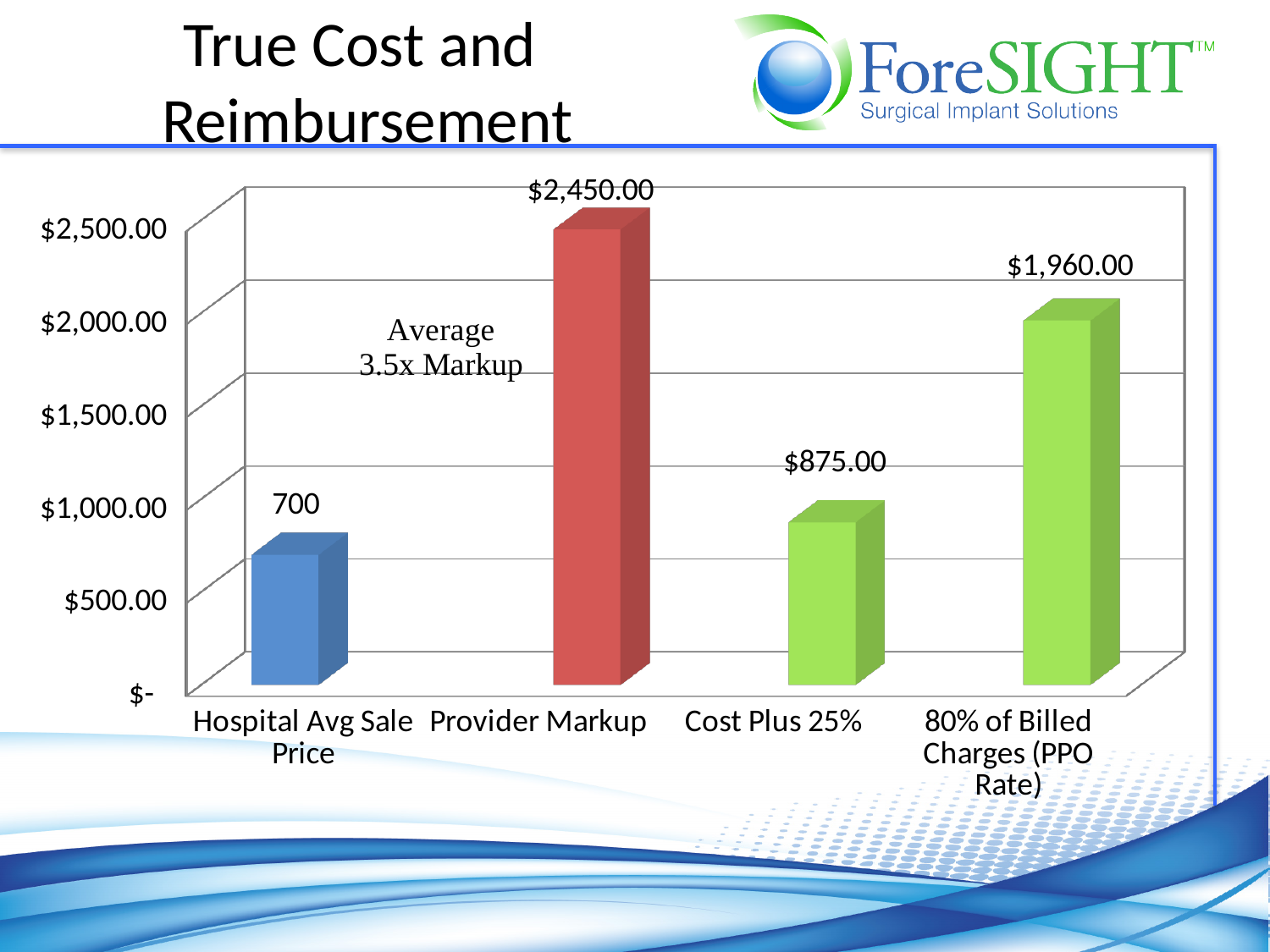
What is the value shown for Cost Plus 25%? $875.00 What kind of chart is shown on the slide? Bar chart What is the difference between the 80% of Billed Charges (PPO Rate) value and the Cost Plus 25% value? $1,085.00 Is the value for Cost Plus 25% greater or less than $1,000.00? less Which category has the highest value? Provider Markup What is the value shown for 80% of Billed Charges (PPO Rate)? $1,960.00 What is the value shown for Provider Markup? $2,450.00 What is the value shown for Hospital Avg Sale Price? 700 What is the difference between the Provider Markup value and the Hospital Avg Sale Price value? $1,750.00 How many categories are shown on the x axis of the chart? 4 Which category has the lowest value? Hospital Avg Sale Price Which is larger, the value for Cost Plus 25% or the value for 80% of Billed Charges (PPO Rate)? 80% of Billed Charges (PPO Rate)